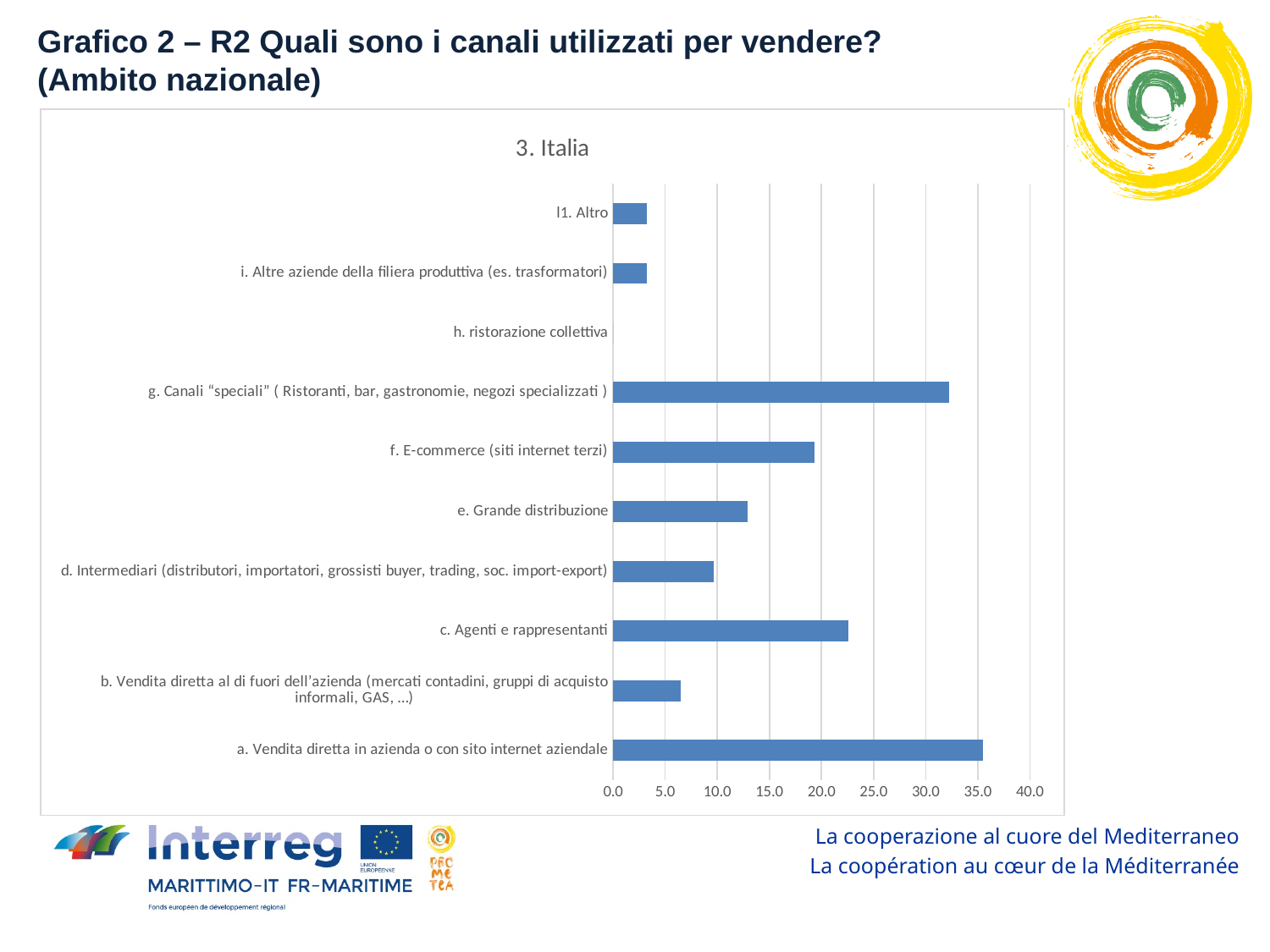
What kind of chart is shown on the slide? bar chart Is the value for 'c. Agenti e rappresentanti' greater or less than 20.0? greater Which sales channel has the lowest value in the chart? h. ristorazione collettiva What is the title shown inside the chart area? 3. Italia Is the value for 'e. Grande distribuzione' greater or less than 10.0? greater Which has a larger value: 'c. Agenti e rappresentanti' or 'f. E-commerce (siti internet terzi)'? c. Agenti e rappresentanti Is the value for 'b. Vendita diretta al di fuori dell'azienda' greater or less than 5.0? greater Which sales channel has the highest value in the chart? a. Vendita diretta in azienda o con sito internet aziendale How many categories (sales channels) are plotted in the chart? 10 Which has a larger value: 'a. Vendita diretta in azienda o con sito internet aziendale' or 'g. Canali "speciali"'? a. Vendita diretta in azienda o con sito internet aziendale